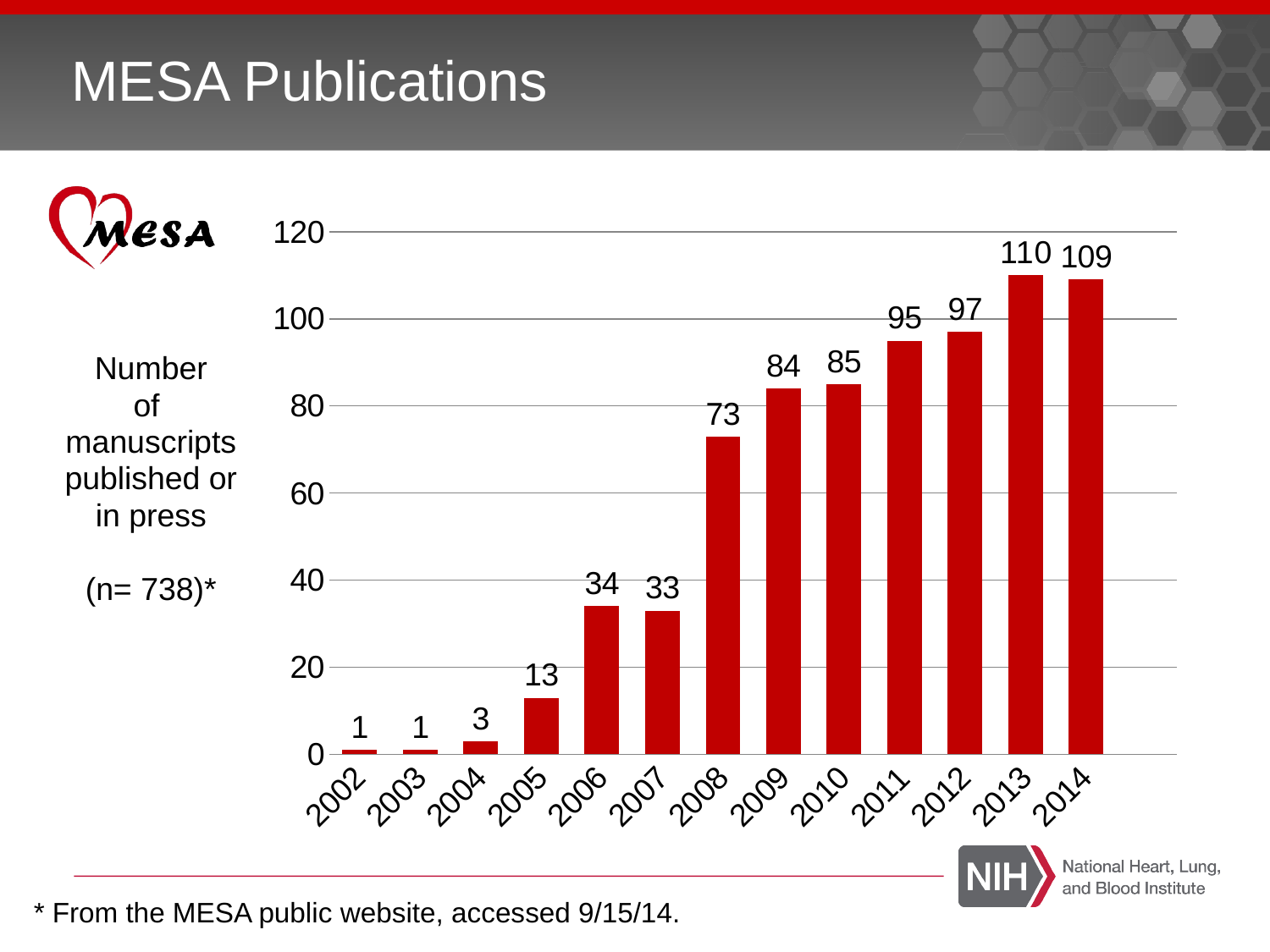
What is the difference between the values for 2008 and 2007? 40 What total number of manuscripts (n) is stated on the slide? 738 Is the value for 2011 greater or less than 80? greater How many years are shown on the x axis? 13 What is the value shown for 2005? 13 What is the value shown for 2013? 110 What is the difference between the values for 2013 and 2014? 1 Do the values generally rise or fall from 2002 to 2013? rise How many manuscripts were published or in press in 2008? 73 What kind of chart is shown on the slide? bar chart Which is larger, the value for 2006 or the value for 2007? 2006 Which year has the highest number of manuscripts? 2013